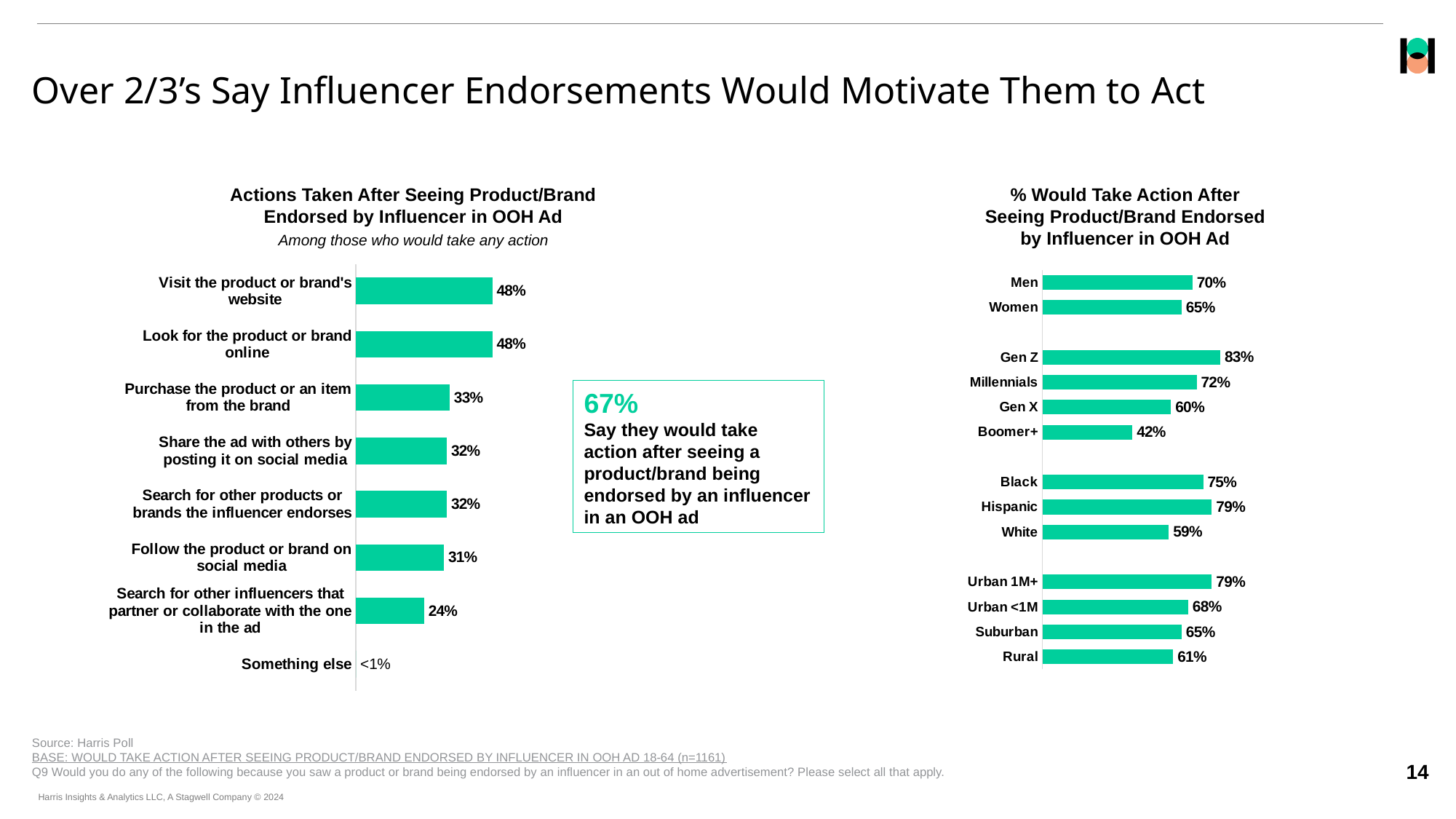
In the '% Would Take Action After Seeing Product/Brand Endorsed by Influencer in OOH Ad' chart, what is the value for Hispanic? 79% In the '% Would Take Action After Seeing Product/Brand Endorsed by Influencer in OOH Ad' chart, which is larger, Men or Women? Men In the '% Would Take Action After Seeing Product/Brand Endorsed by Influencer in OOH Ad' chart, which group has the highest value? Gen Z In the '% Would Take Action After Seeing Product/Brand Endorsed by Influencer in OOH Ad' chart, which group has the lowest value? Boomer+ What kind of chart is the '% Would Take Action After Seeing Product/Brand Endorsed by Influencer in OOH Ad' chart? Bar chart In the '% Would Take Action After Seeing Product/Brand Endorsed by Influencer in OOH Ad' chart, how many groups are shown? 13 In the '% Would Take Action After Seeing Product/Brand Endorsed by Influencer in OOH Ad' chart, what is the difference between Millennials and Gen X? 12% In the 'Actions Taken After Seeing Product/Brand Endorsed by Influencer in OOH Ad' chart, what value is shown for 'Something else'? <1% In the 'Actions Taken After Seeing Product/Brand Endorsed by Influencer in OOH Ad' chart, what percentage would search for other influencers that partner or collaborate with the one in the ad? 24% In the 'Actions Taken After Seeing Product/Brand Endorsed by Influencer in OOH Ad' chart, how many action categories are listed? 8 In the 'Actions Taken After Seeing Product/Brand Endorsed by Influencer in OOH Ad' chart, what percentage would purchase the product or an item from the brand? 33% In the 'Actions Taken After Seeing Product/Brand Endorsed by Influencer in OOH Ad' chart, what is the difference between 'Visit the product or brand's website' and 'Follow the product or brand on social media'? 17%